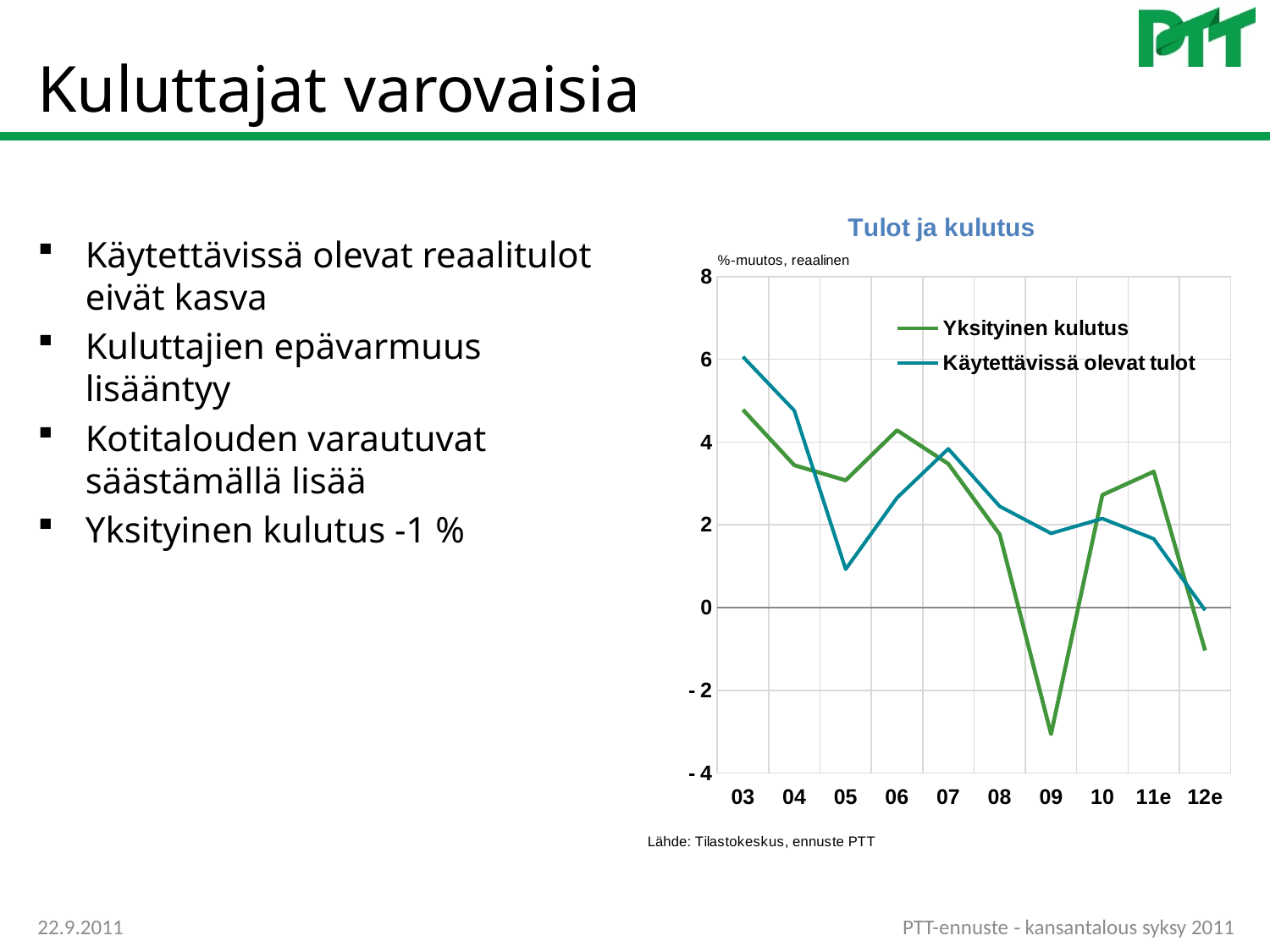
Is the value for Yksityinen kulutus in 09 greater or less than -2? less In which year is Yksityinen kulutus at its lowest? 09 What kind of chart is shown on the slide? line chart In 05, which series has the higher value, Yksityinen kulutus or Käytettävissä olevat tulot? Yksityinen kulutus How many series does the legend of the chart list? 2 In which year is Käytettävissä olevat tulot at its lowest? 12e In which year is Käytettävissä olevat tulot at its highest? 03 What is the title of the chart? Tulot ja kulutus How many years are shown on the x axis of the chart? 10 Does Käytettävissä olevat tulot rise or fall from 03 to 05? fall Is the value for Käytettävissä olevat tulot in 03 greater or less than 4? greater What unit label is shown above the y axis of the chart? %-muutos, reaalinen